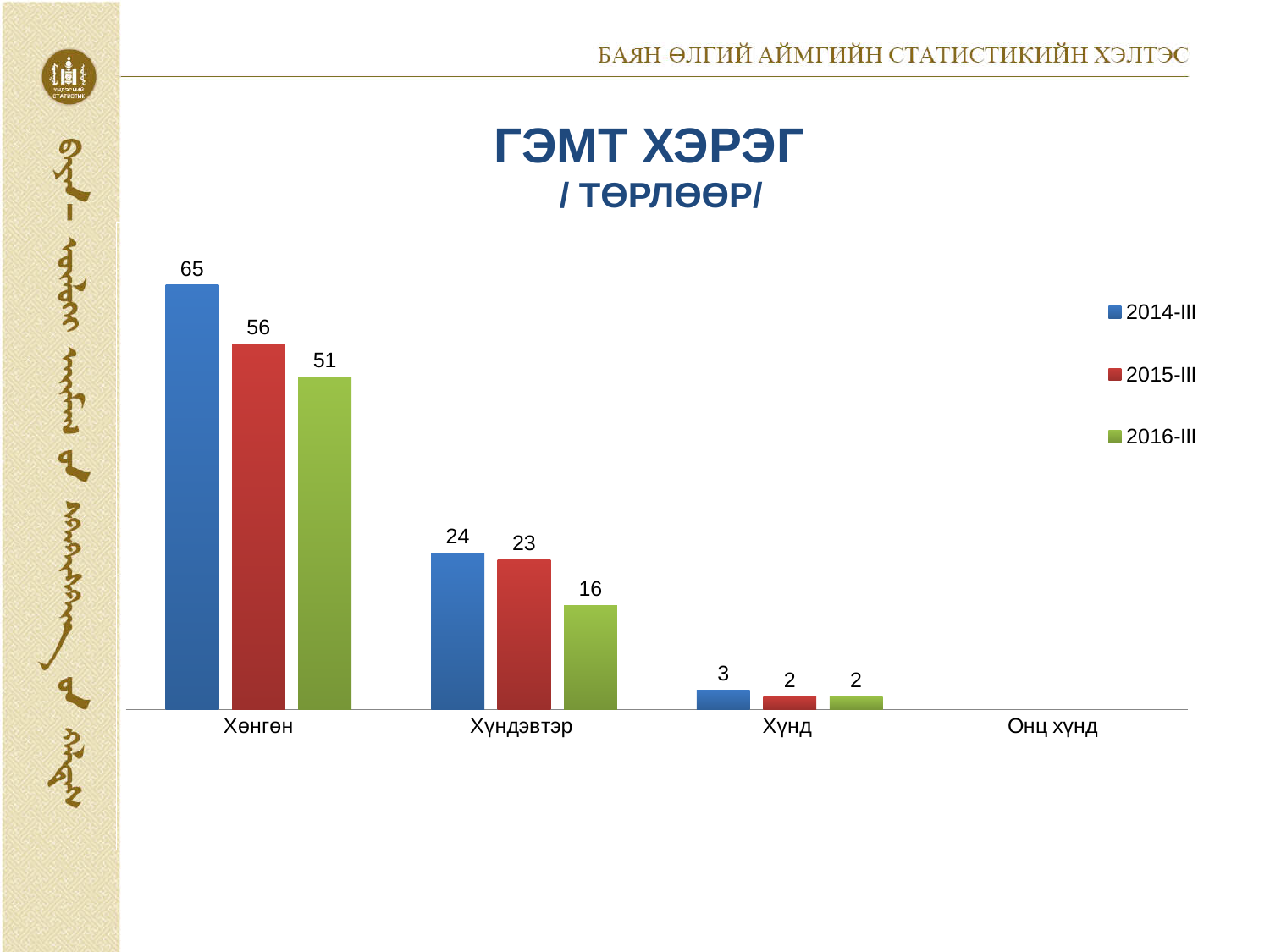
What kind of chart is shown on the slide? Bar chart What is the value for Хүнд in the 2015-III series? 2 What is the value for Хөнгөн in the 2014-III series? 65 Which category has the lowest value in the 2014-III series among those with a visible bar? Хүнд What is the difference between the 2015-III and 2016-III values for Хүндэвтэр? 7 What is the value for Хөнгөн in the 2015-III series? 56 How many categories are shown on the x axis? 4 Which is larger for Хүндэвтэр: the 2014-III value or the 2015-III value? 2014-III What is the difference between the 2014-III and 2016-III values for Хөнгөн? 14 How many series does the legend list? 3 What is the value for Хүндэвтэр in the 2016-III series? 16 Which category has the highest value in the 2016-III series? Хөнгөн